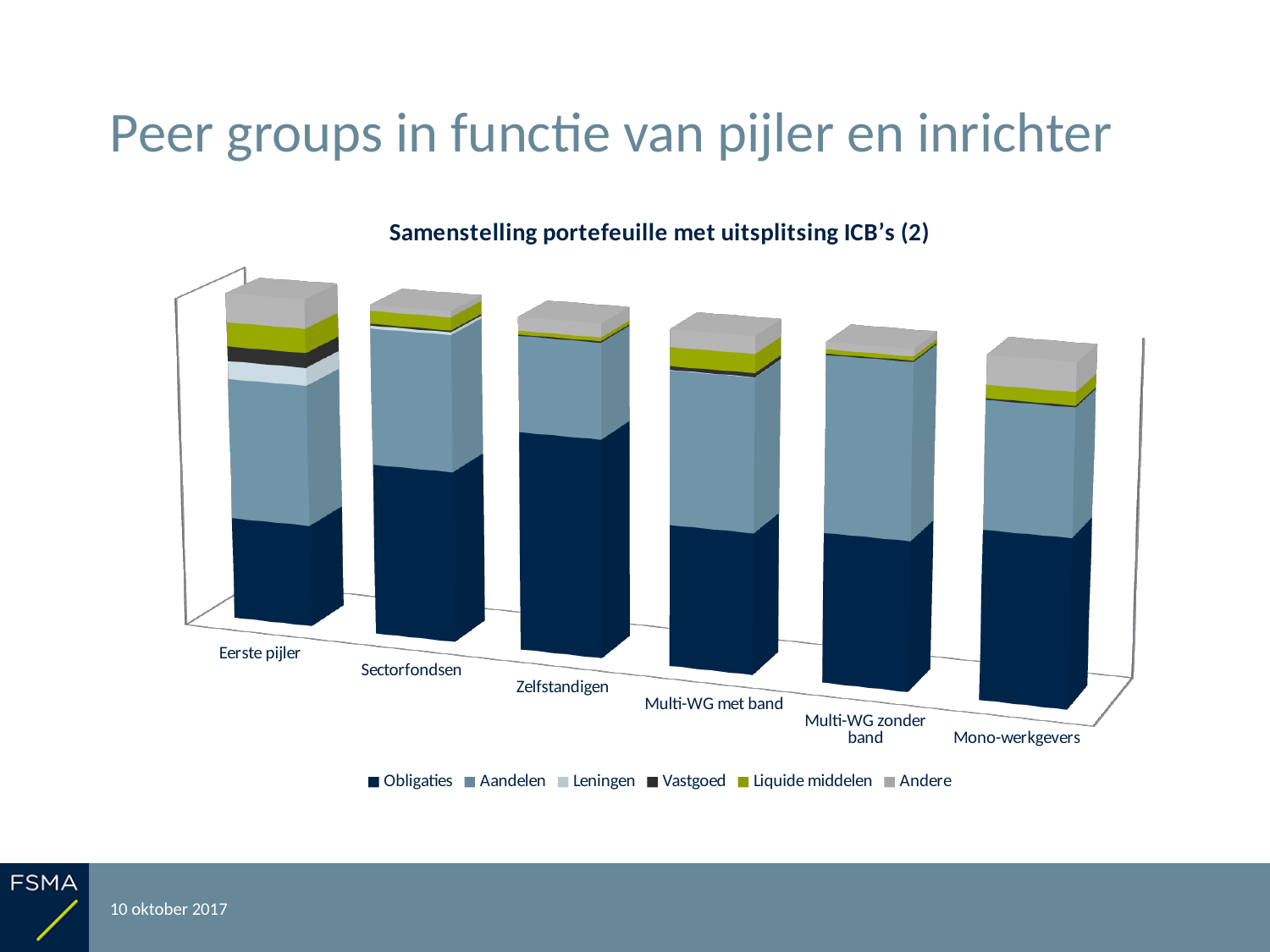
What kind of chart is shown on the slide? Stacked bar chart Is the Obligaties segment larger for Zelfstandigen or for Eerste pijler? Zelfstandigen Which category has the largest Obligaties segment? Zelfstandigen How many categories (peer groups) are shown on the x axis of the chart? 6 Is the Obligaties segment larger for Zelfstandigen or for Mono-werkgevers? Zelfstandigen How many series does the chart legend list? 6 Which series is listed first in the chart legend? Obligaties What is the title of the chart? Samenstelling portefeuille met uitsplitsing ICB's (2) Is the Liquide middelen segment larger for Eerste pijler or for Sectorfondsen? Eerste pijler Which category has the smallest Obligaties segment? Eerste pijler